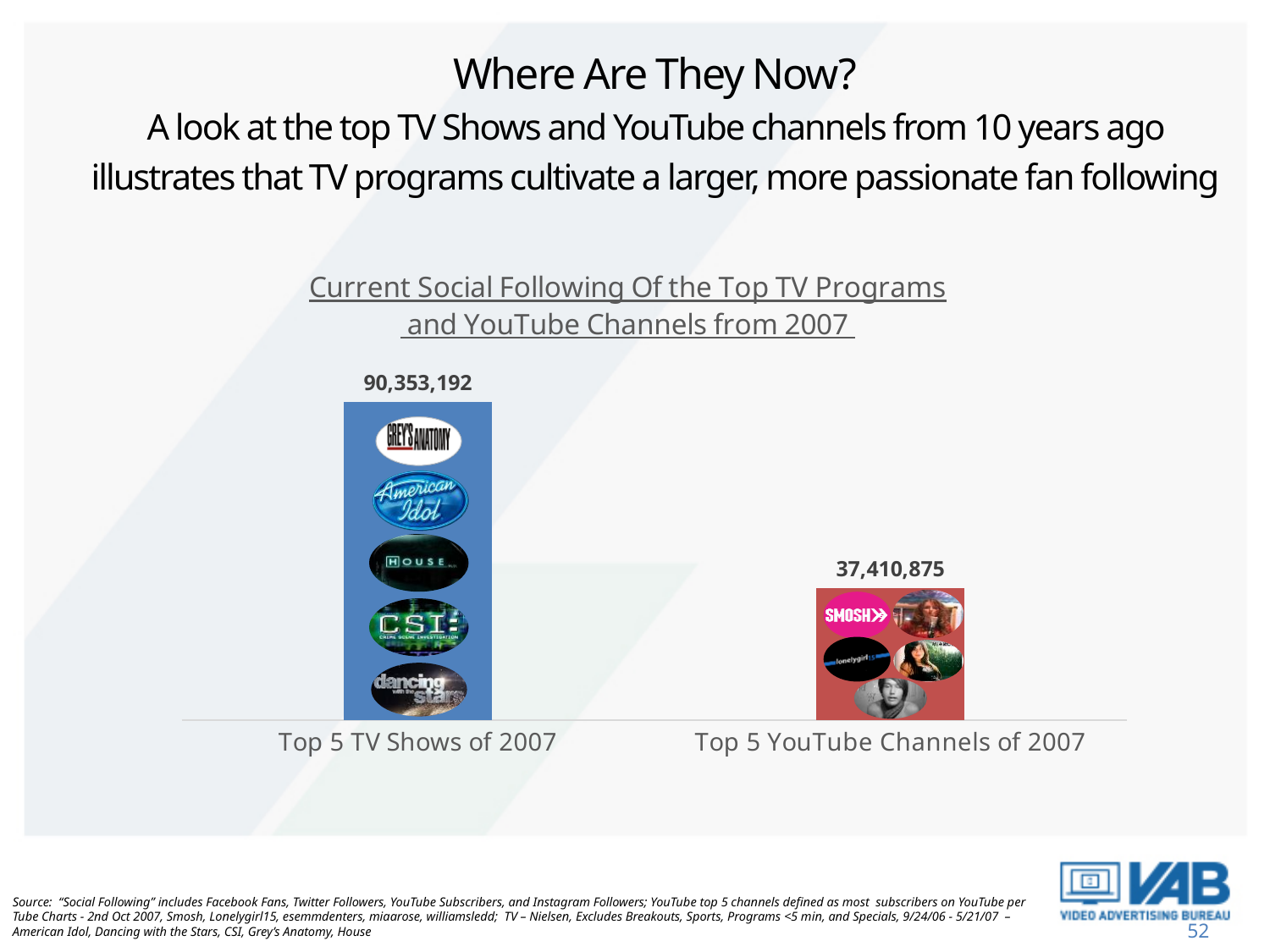
What is the difference in social following between the Top 5 TV Shows of 2007 and the Top 5 YouTube Channels of 2007? 52,942,317 What is the current social following for the Top 5 TV Shows of 2007? 90,353,192 How many categories are shown in the chart? 2 Is the social following larger for the Top 5 TV Shows of 2007 or the Top 5 YouTube Channels of 2007? Top 5 TV Shows of 2007 What is the current social following for the Top 5 YouTube Channels of 2007? 37,410,875 Which category has the lower social following? Top 5 YouTube Channels of 2007 Which category has the higher social following? Top 5 TV Shows of 2007 What kind of chart is shown on the slide? Bar chart What is the title of the chart? Current Social Following Of the Top TV Programs and YouTube Channels from 2007 What is the combined social following of the two categories shown in the chart? 127,764,067